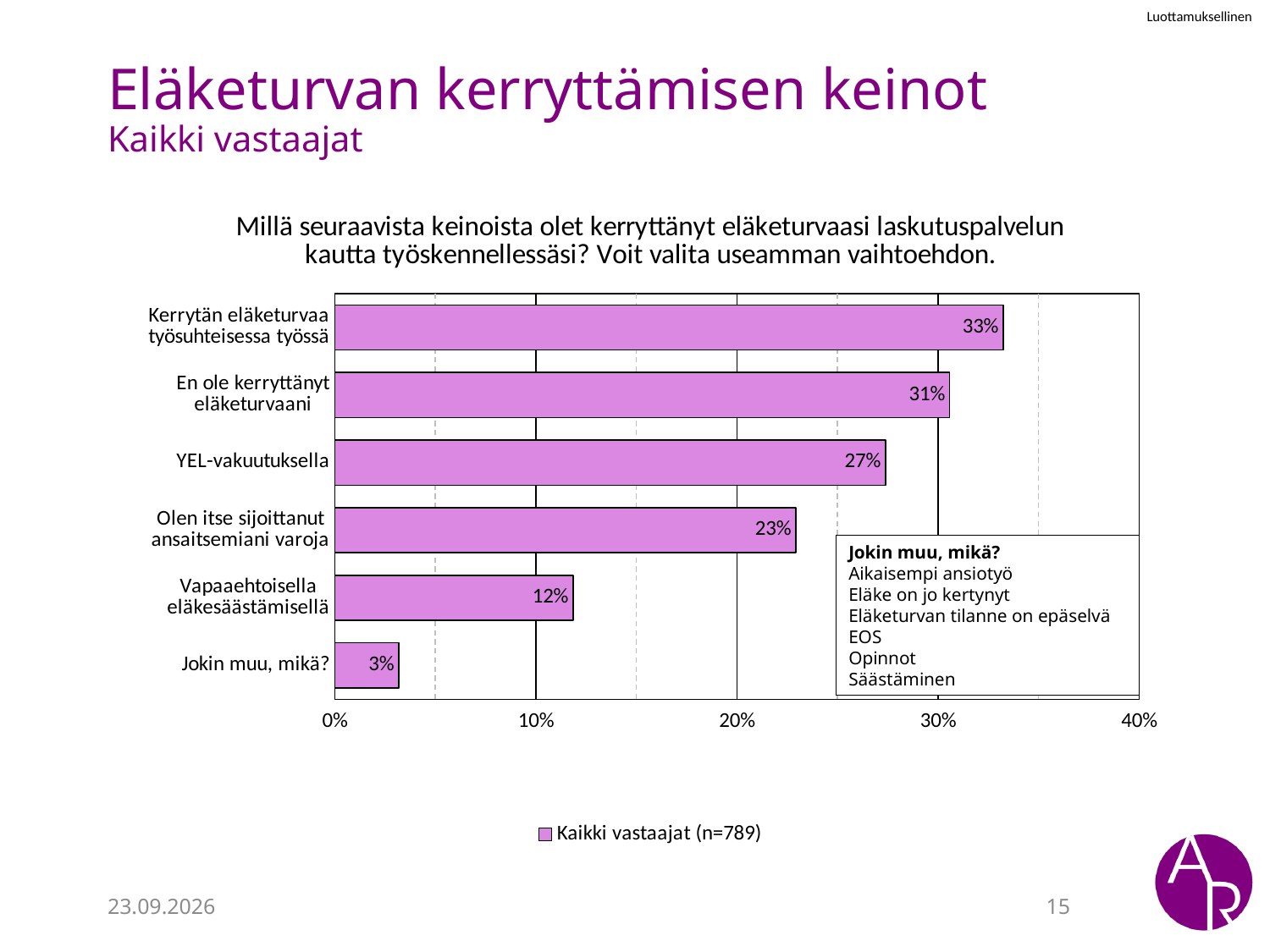
How many categories are shown in the chart? 6 Is the value for "En ole kerryttänyt eläketurvaani" greater or less than 30%? greater What is the value for "Kerrytän eläketurvaa työsuhteisessa työssä"? 33% How many series does the legend list? 1 Which category has the highest value? Kerrytän eläketurvaa työsuhteisessa työssä What kind of chart is shown on the slide? Bar chart What is the value for "YEL-vakuutuksella"? 27% What is the difference between the values for "En ole kerryttänyt eläketurvaani" and "Olen itse sijoittanut ansaitsemiani varoja"? 8% Which is larger, the value for "YEL-vakuutuksella" or the value for "Olen itse sijoittanut ansaitsemiani varoja"? YEL-vakuutuksella What is the value for "Vapaaehtoisella eläkesäästämisellä"? 12% What is the legend entry of the chart? Kaikki vastaajat (n=789) Which category has the lowest value? Jokin muu, mikä?